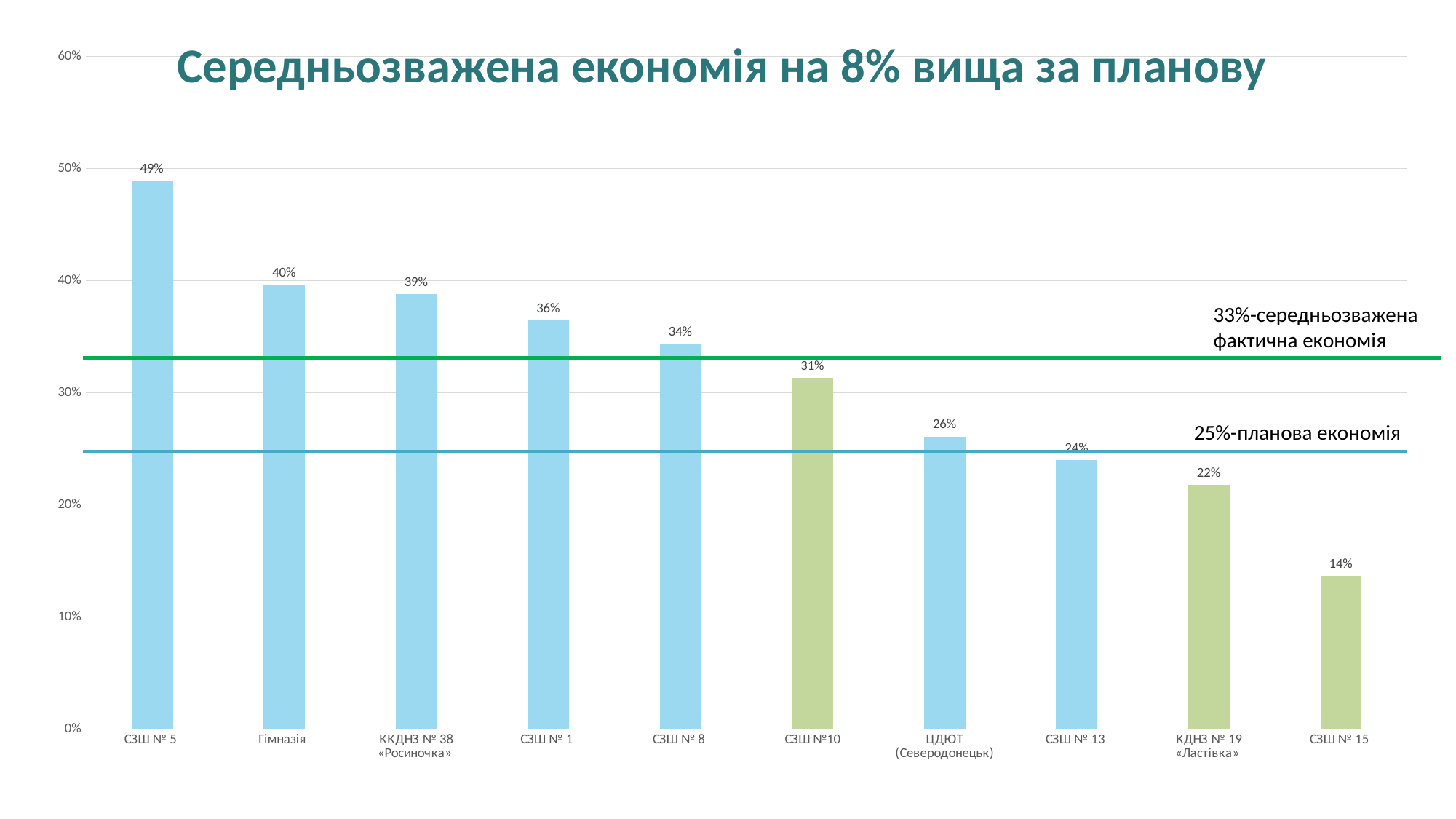
What is the difference between the values for Гімназія and СЗШ № 8? 6% How many categories are shown on the x axis? 10 Which category has the lowest value? СЗШ № 15 Do the bar values rise or fall from left to right along the x axis? fall What is the value for СЗШ № 5? 49% What is the value for КДНЗ № 19 «Ластівка»? 22% Which category has the highest value? СЗШ № 5 What is the value for ЦДЮТ (Северодонецьк)? 26% Is the value for СЗШ № 1 greater or less than 30%? greater Which is larger, the value for СЗШ №10 or the value for СЗШ № 13? СЗШ №10 What kind of chart is shown on the slide? bar chart What value does the green horizontal line labelled «середньозважена фактична економія» mark? 33%